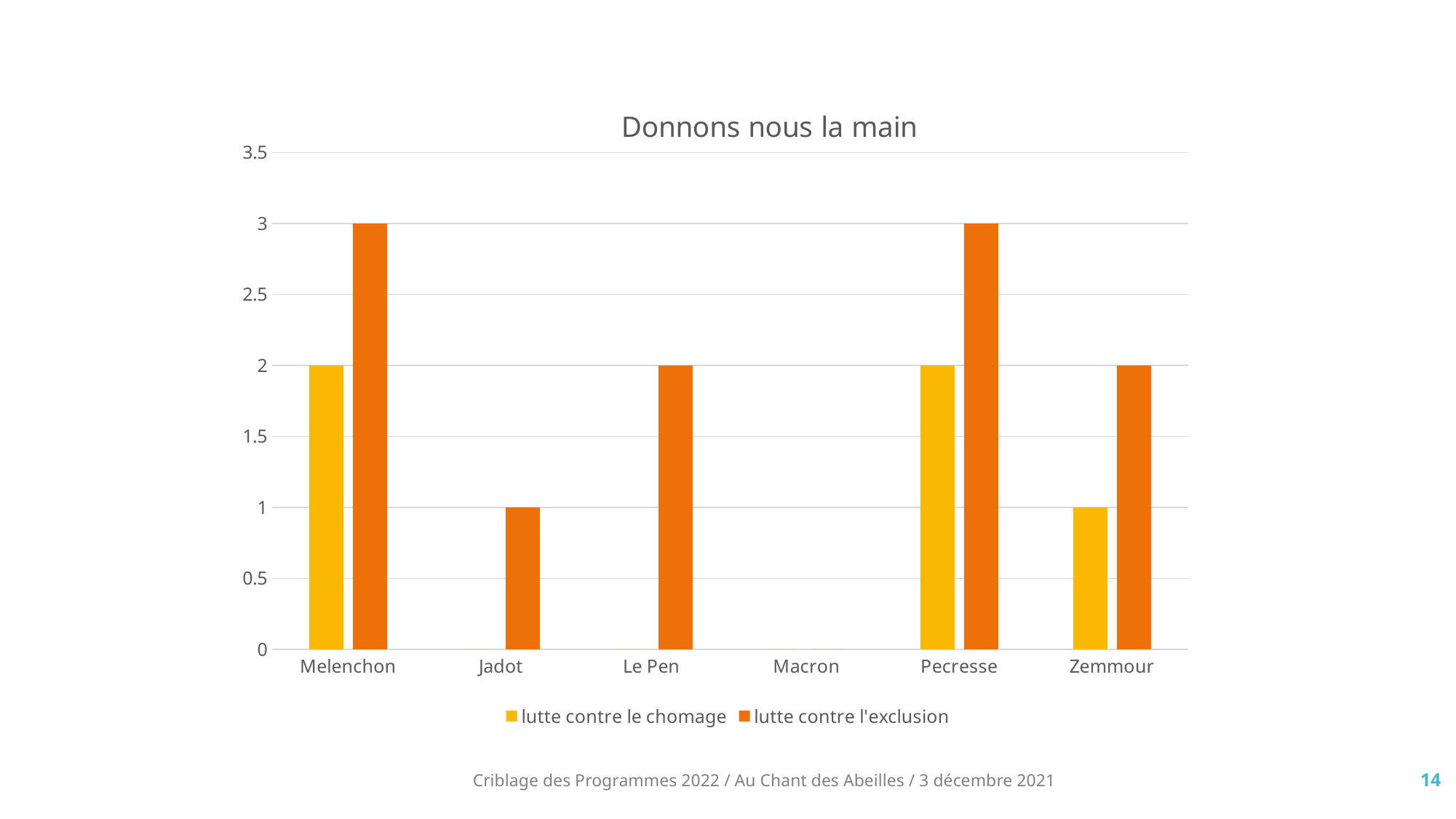
For Zemmour, which series has the larger value: 'lutte contre le chomage' or 'lutte contre l'exclusion'? lutte contre l'exclusion What is the value for Le Pen in the 'lutte contre l'exclusion' series? 2 Is the value for Pecresse in the 'lutte contre l'exclusion' series greater or less than 2.5? greater What is the title of the chart? Donnons nous la main What is the value for Melenchon in the 'lutte contre l'exclusion' series? 3 What is the value for Jadot in the 'lutte contre l'exclusion' series? 1 What is the value for Zemmour in the 'lutte contre le chomage' series? 1 How many series does the legend list? 2 What kind of chart is shown on the slide? bar chart What is the difference between the 'lutte contre l'exclusion' and 'lutte contre le chomage' values for Melenchon? 1 How many candidates are shown on the x axis? 6 Which candidate has the lowest value in the 'lutte contre l'exclusion' series? Macron